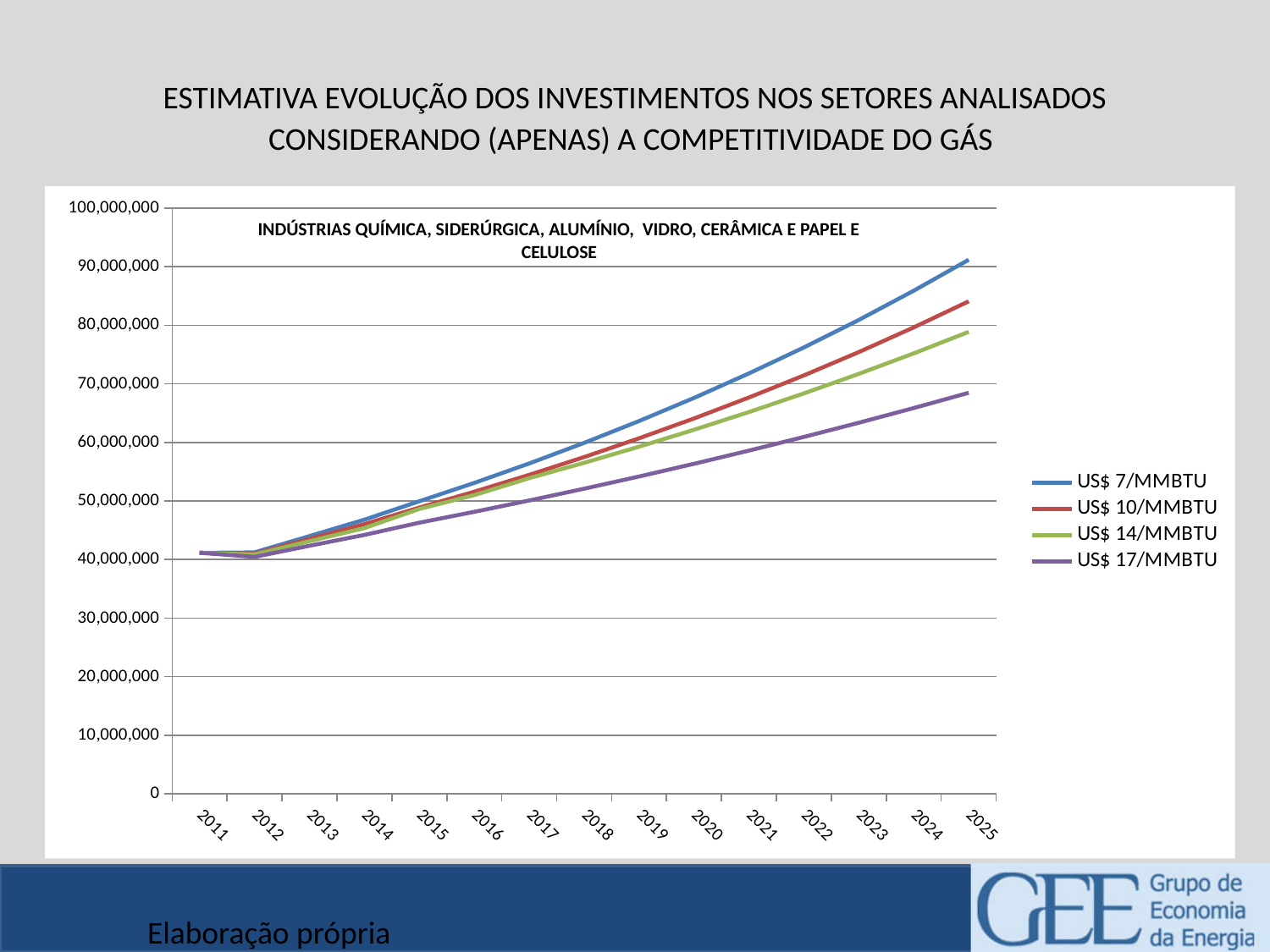
Is the value for US$ 10/MMBTU in 2025 greater or less than 80,000,000? greater How many years are shown along the x axis? 15 Which series has the highest value in 2025? US$ 7/MMBTU What is the title printed inside the chart area? INDÚSTRIAS QUÍMICA, SIDERÚRGICA, ALUMÍNIO, VIDRO, CERÂMICA E PAPEL E CELULOSE What is the first year shown on the x axis? 2011 How many series does the legend list? 4 What kind of chart is shown on the slide? line chart In 2025, which is larger: the value for US$ 10/MMBTU or the value for US$ 17/MMBTU? US$ 10/MMBTU Is the value for US$ 7/MMBTU in 2025 greater or less than 80,000,000? greater Which series has the lowest value in 2025? US$ 17/MMBTU Is the value for US$ 17/MMBTU in 2025 greater or less than 70,000,000? less Do the values of the US$ 7/MMBTU series rise or fall from 2012 to 2025? rise